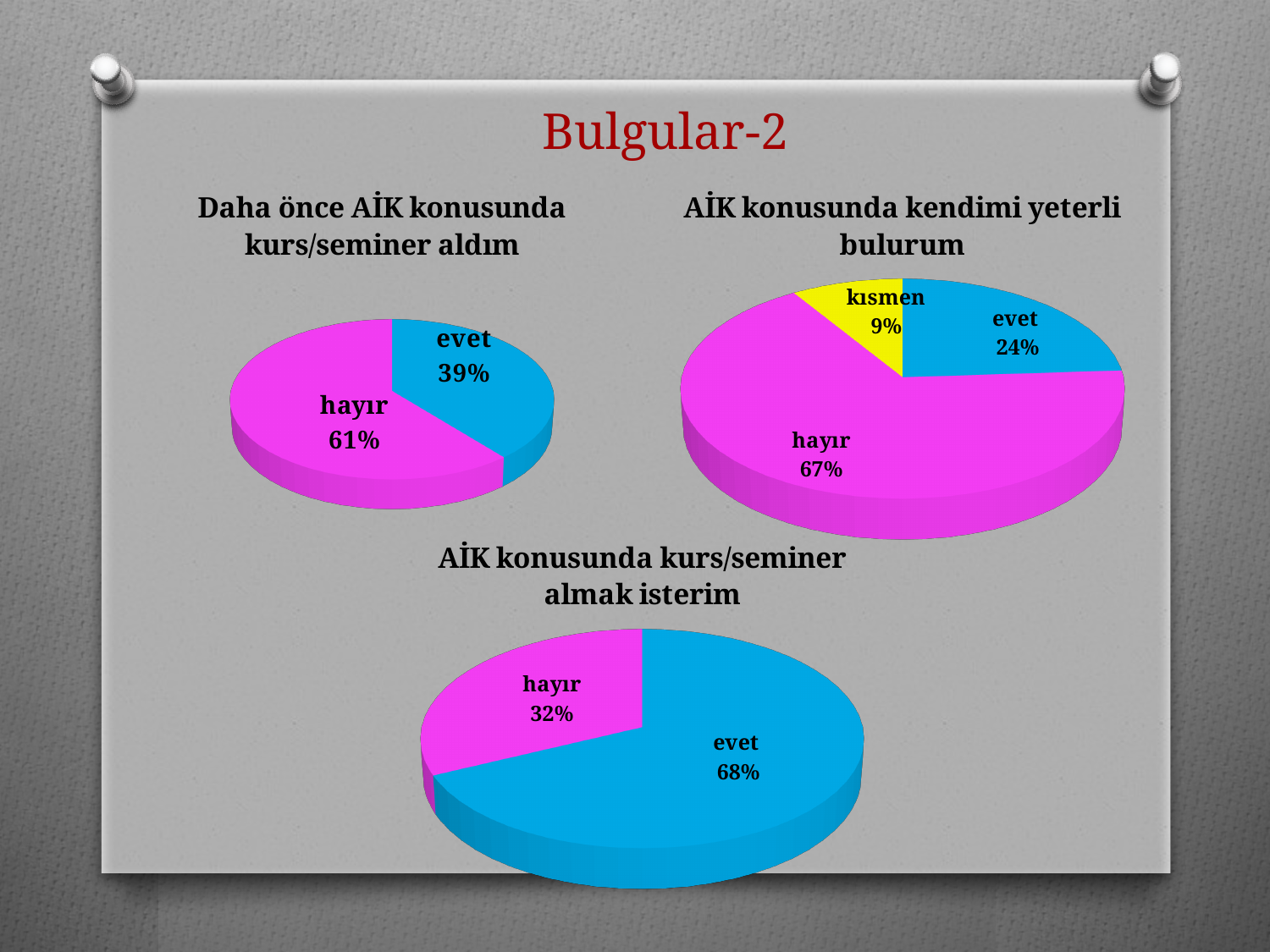
In the chart titled 'Daha önce AİK konusunda kurs/seminer aldım', what is the share for 'evet'? 39% In the chart titled 'AİK konusunda kurs/seminer almak isterim', what is the difference between the 'evet' and 'hayır' shares? 36% In the chart titled 'Daha önce AİK konusunda kurs/seminer aldım', what is the share for 'hayır'? 61% In the chart titled 'AİK konusunda kendimi yeterli bulurum', what is the share for 'kısmen'? 9% In the chart titled 'Daha önce AİK konusunda kurs/seminer aldım', which is larger, 'evet' or 'hayır'? hayır In the chart titled 'AİK konusunda kendimi yeterli bulurum', how many slices does the pie have? 3 How many pie charts are shown on the slide? 3 In the chart titled 'AİK konusunda kendimi yeterli bulurum', which slice is the smallest? kısmen In the chart titled 'AİK konusunda kurs/seminer almak isterim', what is the share for 'evet'? 68% What kind of chart is used for 'Daha önce AİK konusunda kurs/seminer aldım'? Pie chart In the chart titled 'AİK konusunda kendimi yeterli bulurum', which slice is the largest? hayır In the chart titled 'AİK konusunda kendimi yeterli bulurum', what is the difference between the 'hayır' and 'evet' shares? 43%